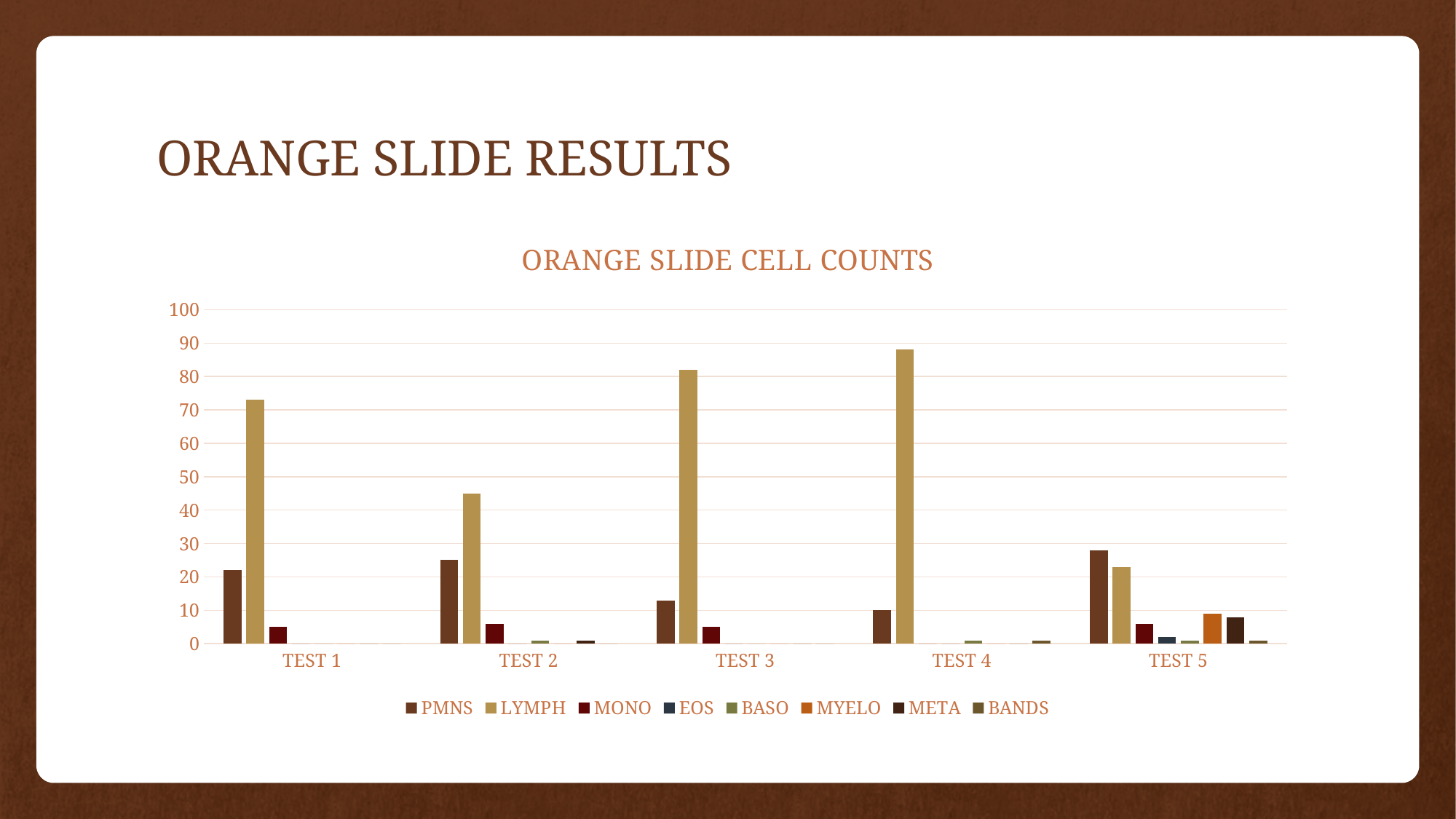
Which test has the highest LYMPH value? TEST 4 Is the PMNS value for TEST 3 greater or less than 20? less What is the title of the chart? ORANGE SLIDE CELL COUNTS Which is larger for TEST 5, the PMNS value or the LYMPH value? PMNS Is the LYMPH value for TEST 1 greater or less than 70? greater Which test has the highest PMNS value? TEST 5 What kind of chart is shown on the slide? bar chart How many series does the legend list? 8 Is the LYMPH value for TEST 2 greater or less than 50? less Which test has the lowest LYMPH value? TEST 5 Which is larger for TEST 3, the LYMPH value or the PMNS value? LYMPH How many test categories are shown on the x axis? 5